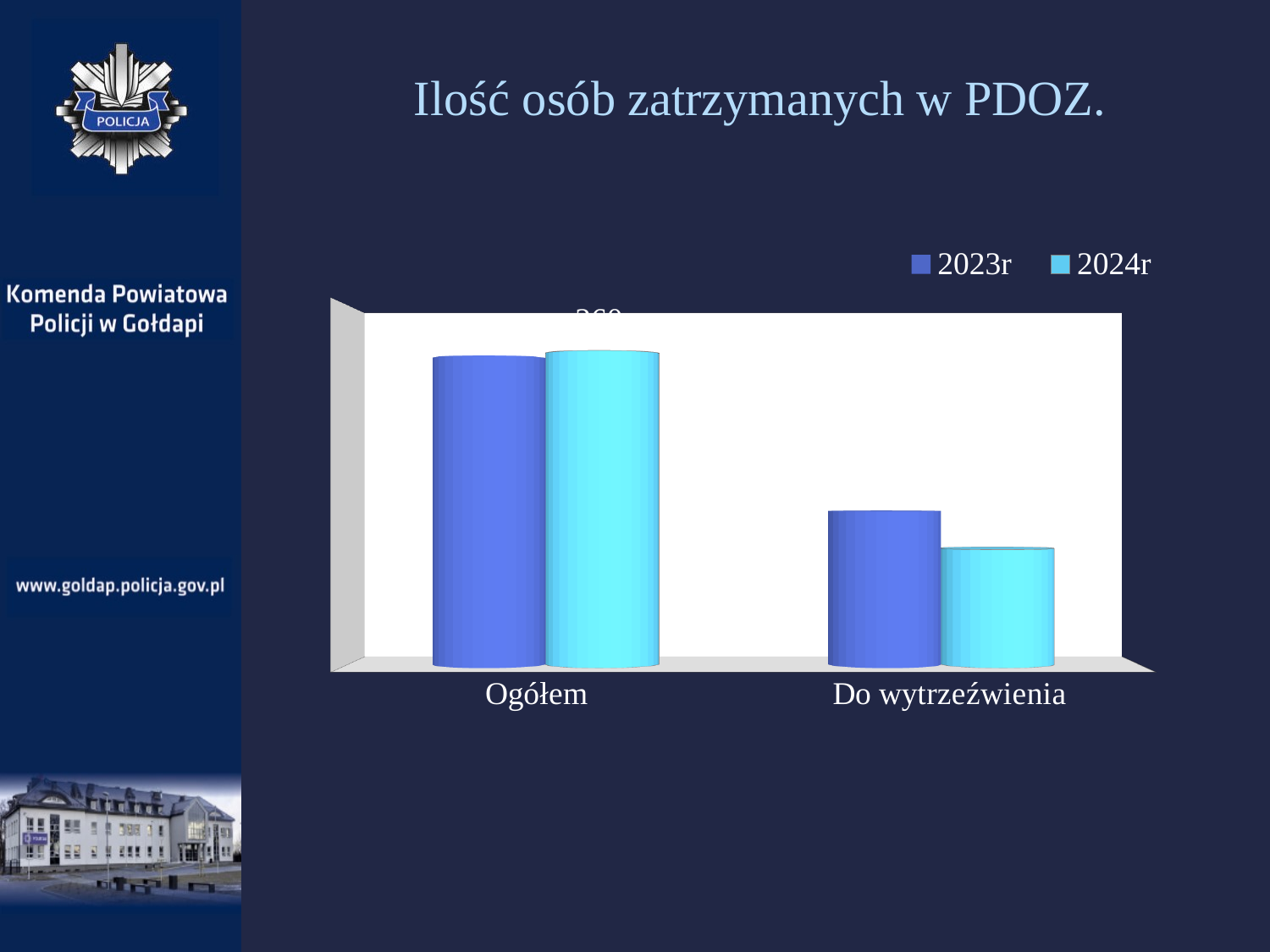
How many categories are shown on the x axis? 2 Which category has the lowest value for the 2024r series? Do wytrzeźwienia For the category Do wytrzeźwienia, which series has the larger value, 2023r or 2024r? 2023r What kind of chart is shown on the slide? bar chart Which category has the larger value for 2024r, Ogółem or Do wytrzeźwienia? Ogółem Do the values for the 2023r series rise or fall from Ogółem to Do wytrzeźwienia? fall How many series does the legend list? 2 What is the title of the chart? Ilość osób zatrzymanych w PDOZ. Which category has the highest value for the 2023r series? Ogółem Which series is shown in the lighter cyan colour? 2024r